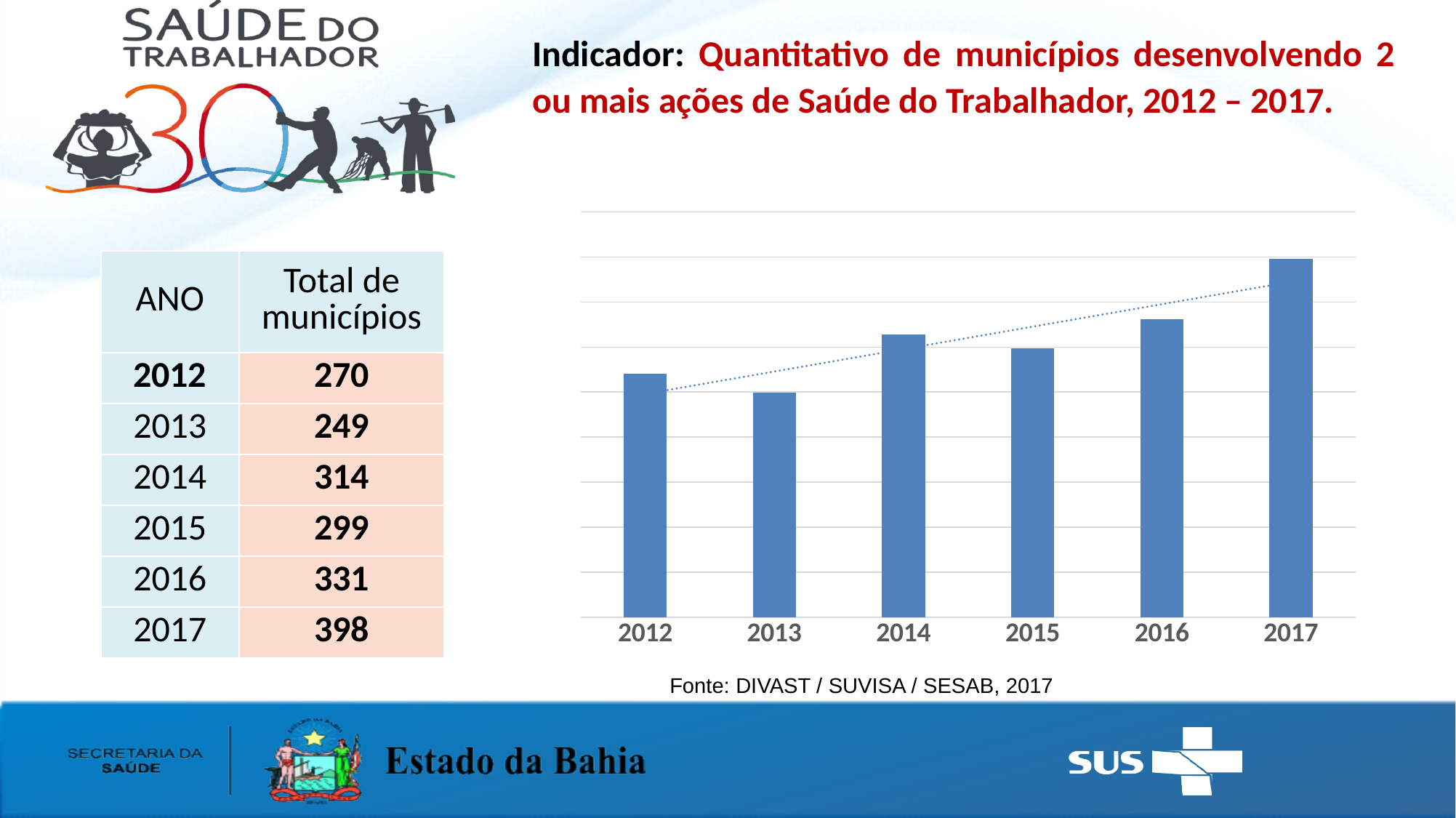
What is the total number of municipalities for 2013? 249 What is the total number of municipalities for 2015? 299 What kind of chart is shown on the slide? bar chart Which year has the highest total of municipalities? 2017 Which year has a larger total of municipalities, 2014 or 2015? 2014 What is the difference between the totals for 2017 and 2016? 67 Which year has a larger total of municipalities, 2012 or 2013? 2012 What is the total number of municipalities for 2017? 398 What is the difference between the totals for 2014 and 2013? 65 Which year has the lowest total of municipalities? 2013 What is the source cited below the chart? DIVAST / SUVISA / SESAB, 2017 How many years are shown on the chart? 6